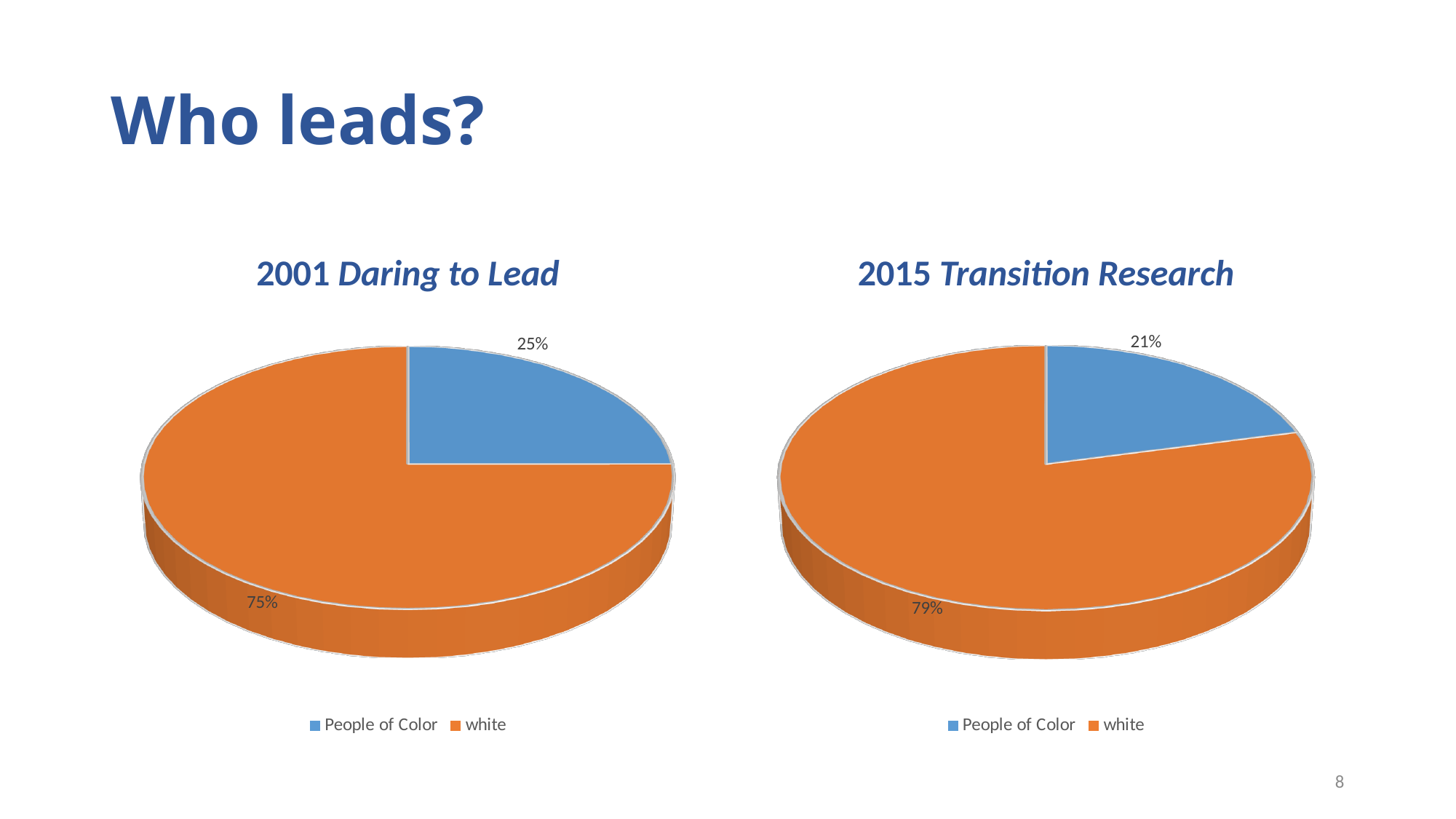
In the 2015 Transition Research chart, what share of the pie is white? 79% How many categories does the legend of the 2001 Daring to Lead chart list? 2 In the 2001 Daring to Lead chart, what share of the pie is People of Color? 25% In the 2015 Transition Research chart, what is the difference between the white and People of Color shares? 58% Which chart shows a larger share for People of Color, 2001 Daring to Lead or 2015 Transition Research? 2001 Daring to Lead In the 2001 Daring to Lead chart, what colour is the People of Color slice? Blue In the 2015 Transition Research chart, which category has the smallest slice? People of Color In the 2001 Daring to Lead chart, which category has the largest slice? white In the 2001 Daring to Lead chart, what is the difference between the white and People of Color shares? 50% In the 2015 Transition Research chart, what share of the pie is People of Color? 21% What kind of chart is the 2015 Transition Research chart? Pie chart